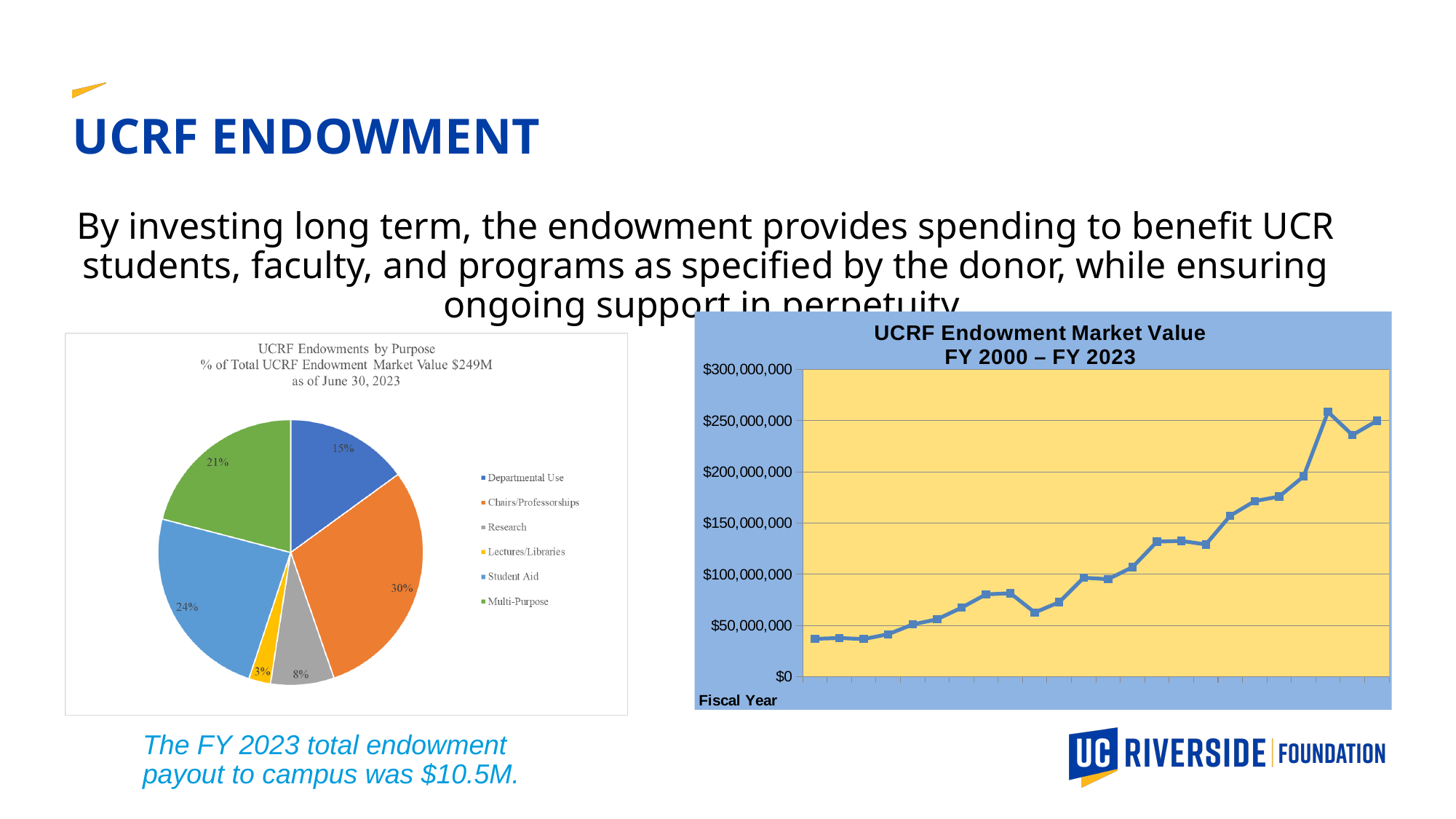
In the UCRF Endowment Market Value chart, does the market value generally rise or fall from FY 2000 to FY 2023? Rise In the UCRF Endowments by Purpose chart, which is larger: Multi-Purpose or Research? Multi-Purpose In the UCRF Endowments by Purpose chart, which purpose has the largest share? Chairs/Professorships In the UCRF Endowments by Purpose chart, what is the difference in percentage points between Student Aid and Departmental Use? 9 In the UCRF Endowments by Purpose chart, what percentage is Chairs/Professorships? 30% What kind of chart is the UCRF Endowments by Purpose chart? Pie chart In the UCRF Endowments by Purpose chart, which purpose has the smallest share? Lectures/Libraries In the UCRF Endowment Market Value chart, is the value at the first point (FY 2000) greater or less than $50,000,000? less In the UCRF Endowments by Purpose chart, what percentage is Lectures/Libraries? 3% What kind of chart is the UCRF Endowment Market Value FY 2000 – FY 2023 chart? Line chart In the UCRF Endowments by Purpose chart, what share of the pie is Student Aid? 24% How many purposes does the legend of the UCRF Endowments by Purpose chart list? 6